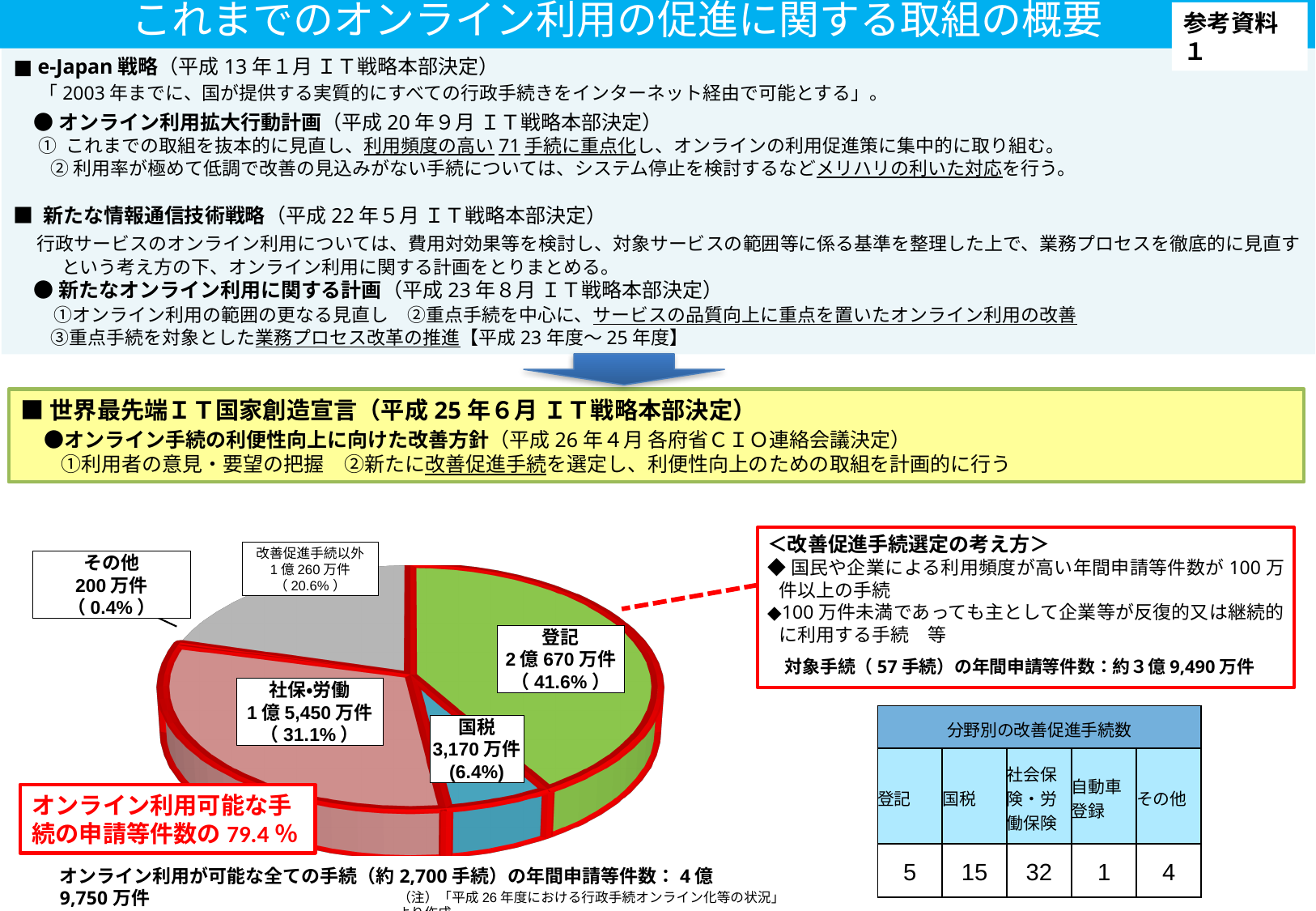
What is the value shown for その他 in the pie chart? 200万件 Which slice of the pie chart is the smallest? その他 What is the value shown for 改善促進手続以外 in the pie chart? 1億260万件 What is the value shown for 社保・労働 in the pie chart? 1億5,450万件 What share of the pie does 社保・労働 represent? 31.1% What kind of chart is shown on the slide? pie chart What is the value shown for 国税 in the pie chart? 3,170万件 How many slices does the pie chart have? 5 Which is larger in the pie chart, 国税 or その他? 国税 What is the difference in percentage points between the 登記 share (41.6%) and the 社保・労働 share (31.1%)? 10.5% What is the value shown for 登記 in the pie chart? 2億670万件 Which slice of the pie chart is the largest? 登記